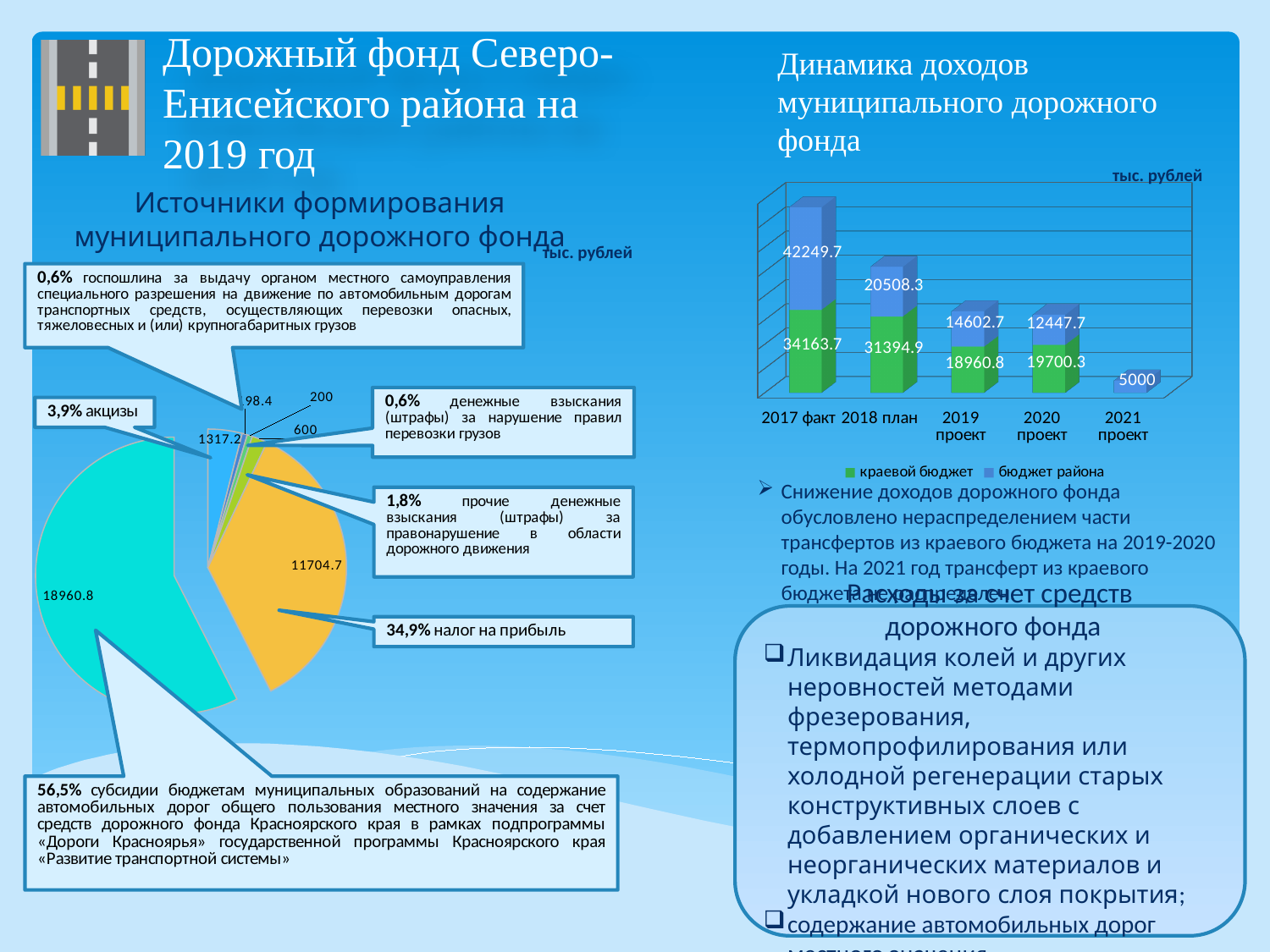
In the chart 'Динамика доходов муниципального дорожного фонда', what is the value for бюджет района in 2017 факт? 42249.7 In the chart 'Динамика доходов муниципального дорожного фонда', what is the difference between краевой бюджет and бюджет района in 2019 проект? 4358.1 In the chart 'Динамика доходов муниципального дорожного фонда', how many year categories are shown on the x axis? 5 In the chart 'Динамика доходов муниципального дорожного фонда', what is the total of the stacked bar for 2018 план? 51903.2 In the chart 'Динамика доходов муниципального дорожного фонда', how many series does the legend list? 2 What kind of chart is 'Источники формирования муниципального дорожного фонда'? pie chart In the pie chart 'Источники формирования муниципального дорожного фонда', what is the value of the slice for налог на прибыль? 11704.7 In the chart 'Динамика доходов муниципального дорожного фонда', which year has the highest value for бюджет района? 2017 факт In the chart 'Динамика доходов муниципального дорожного фонда', do the values for бюджет района rise or fall from 2017 факт to 2021 проект? fall In the chart 'Динамика доходов муниципального дорожного фонда', what is the value for краевой бюджет in 2020 проект? 19700.3 In the pie chart 'Источники формирования муниципального дорожного фонда', what share does the slice for акцизы have? 3,9% In the chart 'Динамика доходов муниципального дорожного фонда', what is the value for краевой бюджет in 2018 план? 31394.9